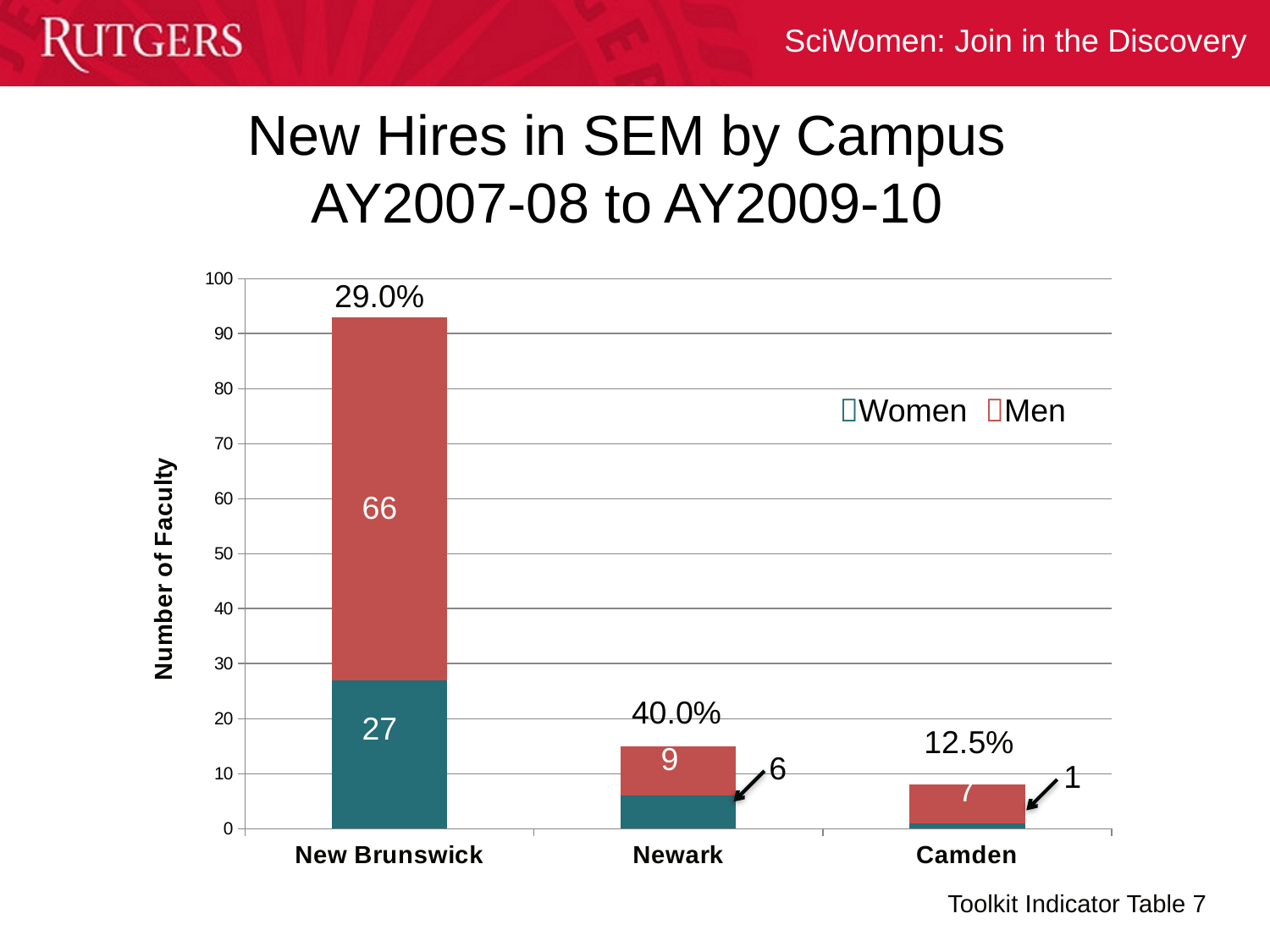
What percentage is shown above the Camden bar? 12.5% What is the number of men hired at Newark? 9 What is the number of women hired at Newark? 6 What is the number of women hired at New Brunswick? 27 What type of chart is shown on the slide? Stacked bar chart Which campus has the highest total number of new hires? New Brunswick What is the label on the y axis? Number of Faculty What is the total number of new hires at New Brunswick (women plus men)? 93 How many series does the legend list? 2 What is the difference between the number of men and women hired at New Brunswick? 39 What is the number of men hired at New Brunswick? 66 How many campuses are shown on the x axis? 3